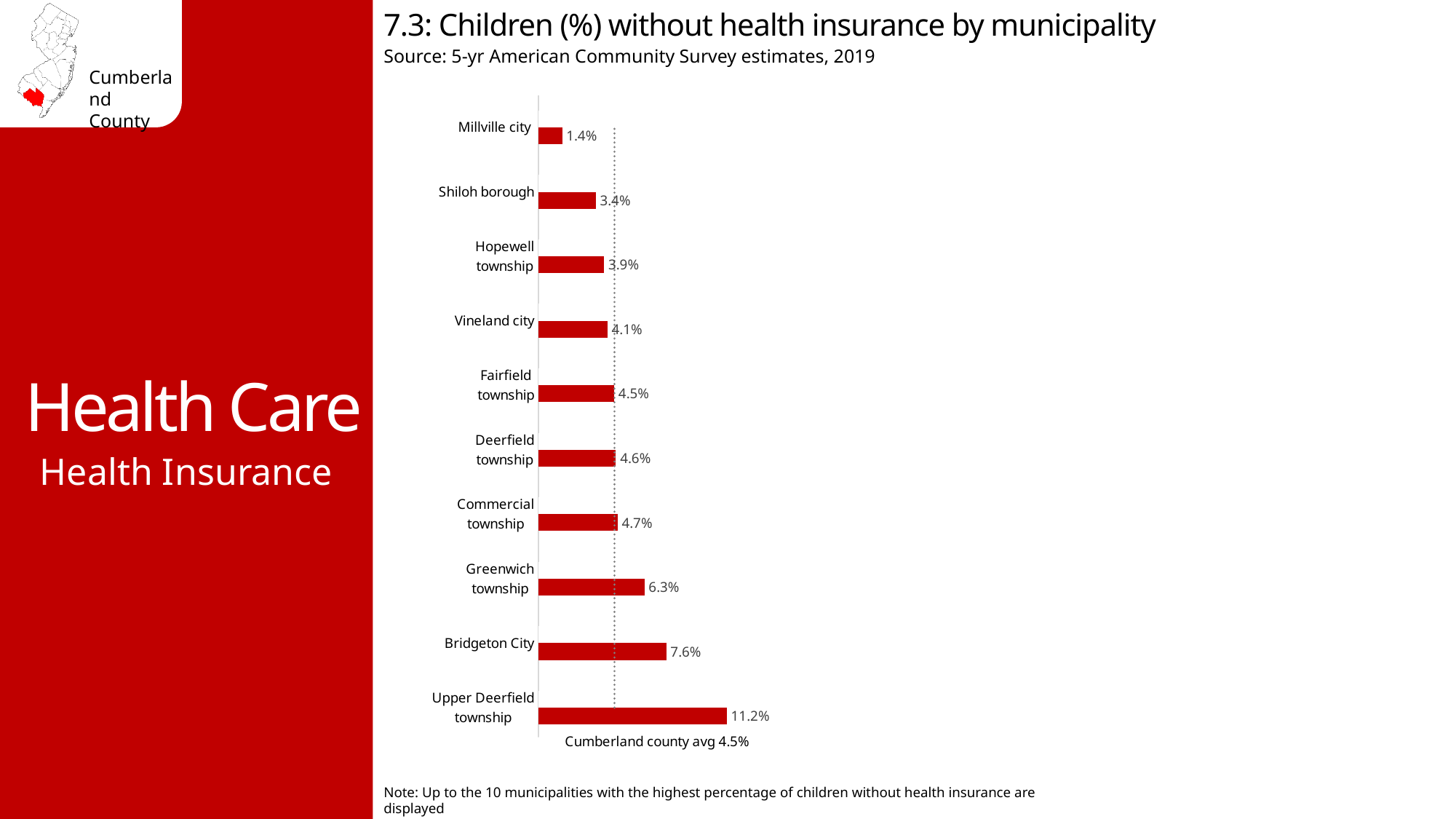
What is the value shown for Bridgeton City? 7.6% Which municipality has the highest percentage of children without health insurance? Upper Deerfield township Which has a higher value, Shiloh borough or Vineland city? Vineland city How many municipalities are shown in the chart? 10 What percentage of children in Upper Deerfield township are without health insurance? 11.2% What is the Cumberland county average shown by the dotted line? 4.5% What kind of chart is used on this slide? Bar chart What is the value for Greenwich township? 6.3% What is the source of the data in the chart? 5-yr American Community Survey estimates, 2019 What percentage is shown for Millville city? 1.4% What is the difference between the values for Upper Deerfield township and Bridgeton City? 3.6% Which municipality has the lowest percentage of children without health insurance? Millville city